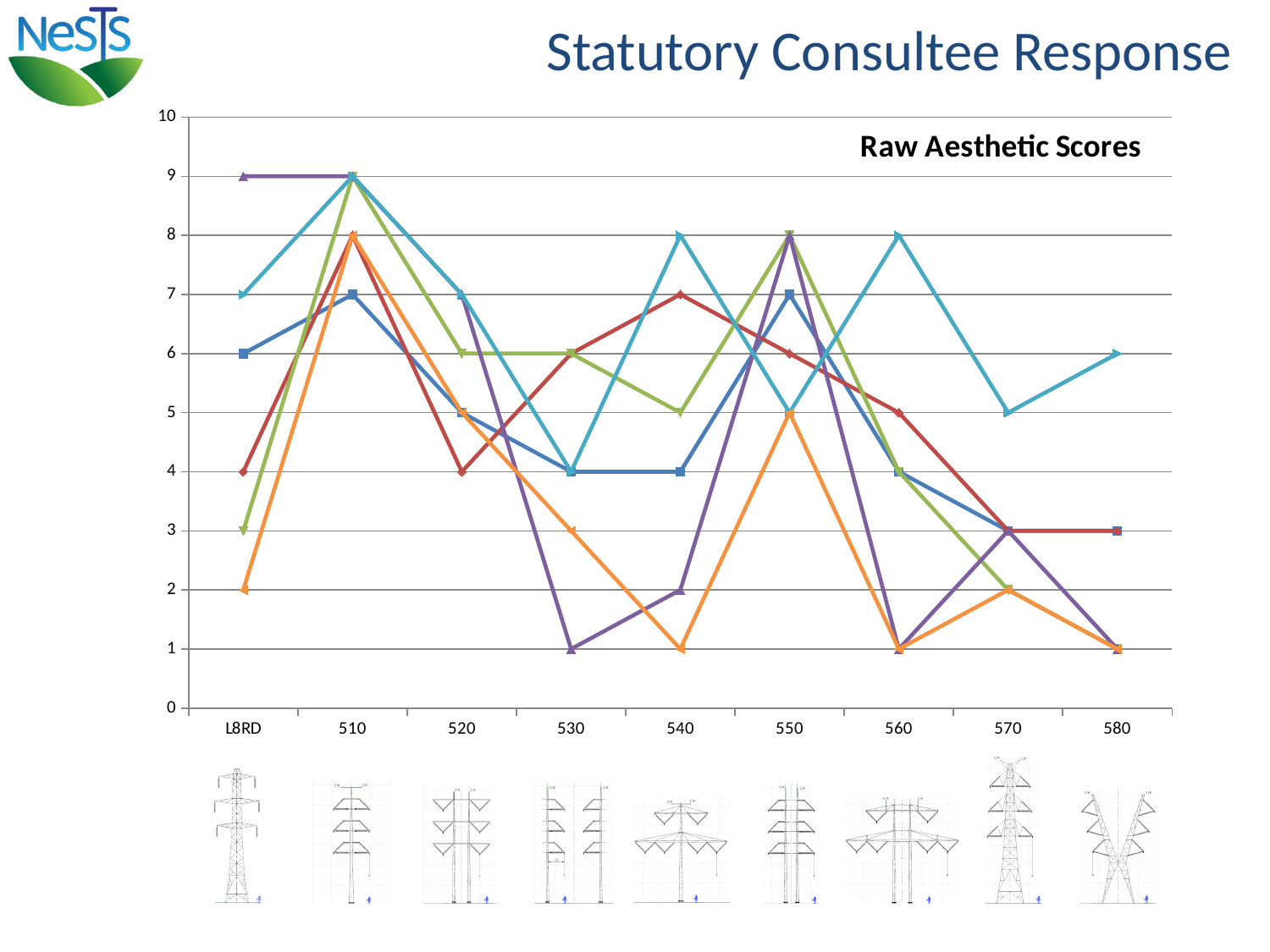
What is the value of the red line at 540? 7 Is the value of the light blue (cyan) line at 560 greater or less than 5? greater Does the orange line rise or fall from 550 to 560? fall What kind of chart is shown on the slide? line chart What is the value of the light blue (cyan) line at 580? 6 What is the value of the purple line at 530? 1 What is the title printed inside the chart area? Raw Aesthetic Scores At 540, what is the difference between the light blue (cyan) line's value and the orange line's value? 7 At 540, which line has the larger value, the light blue (cyan) line or the orange line? light blue (cyan) line How many categories are shown along the x axis of the chart? 9 At which category does the light blue (cyan) line reach its highest value? 510 At which category does the light blue (cyan) line reach its lowest value? 530